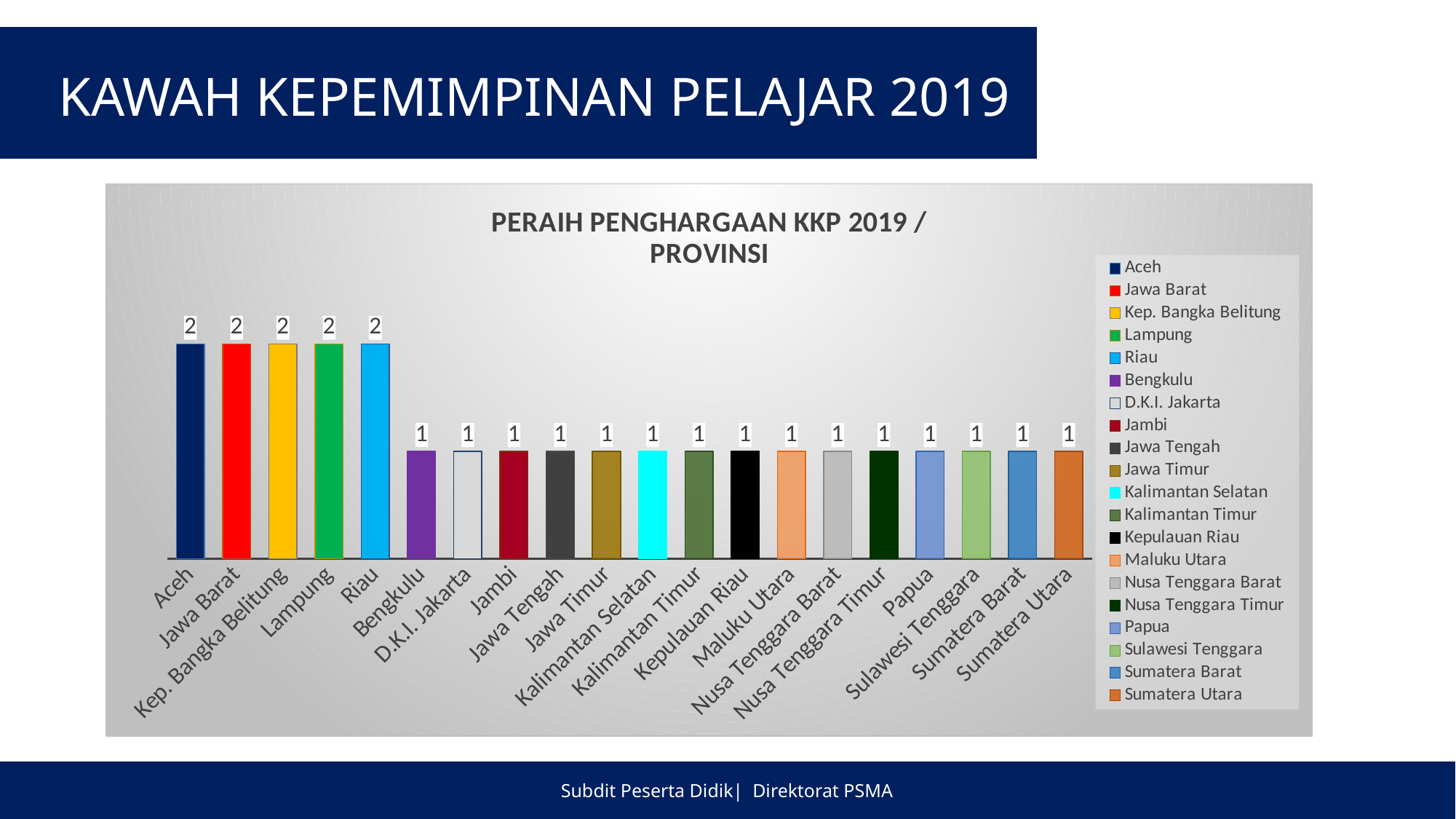
How many provinces have a value of 2? 5 What kind of chart is shown on the slide? Bar chart What is the value for Aceh? 2 What is the title of the chart? PERAIH PENGHARGAAN KKP 2019 / PROVINSI How many entries does the chart legend list? 20 Which is larger, the value for Jawa Barat or the value for Jambi? Jawa Barat What is the value for Riau? 2 What is the value for Sumatera Utara? 1 What is the value for Bengkulu? 1 How many provinces are shown on the x axis of the chart? 20 What is the value for Lampung? 2 What is the difference between the value for Kep. Bangka Belitung and the value for Papua? 1